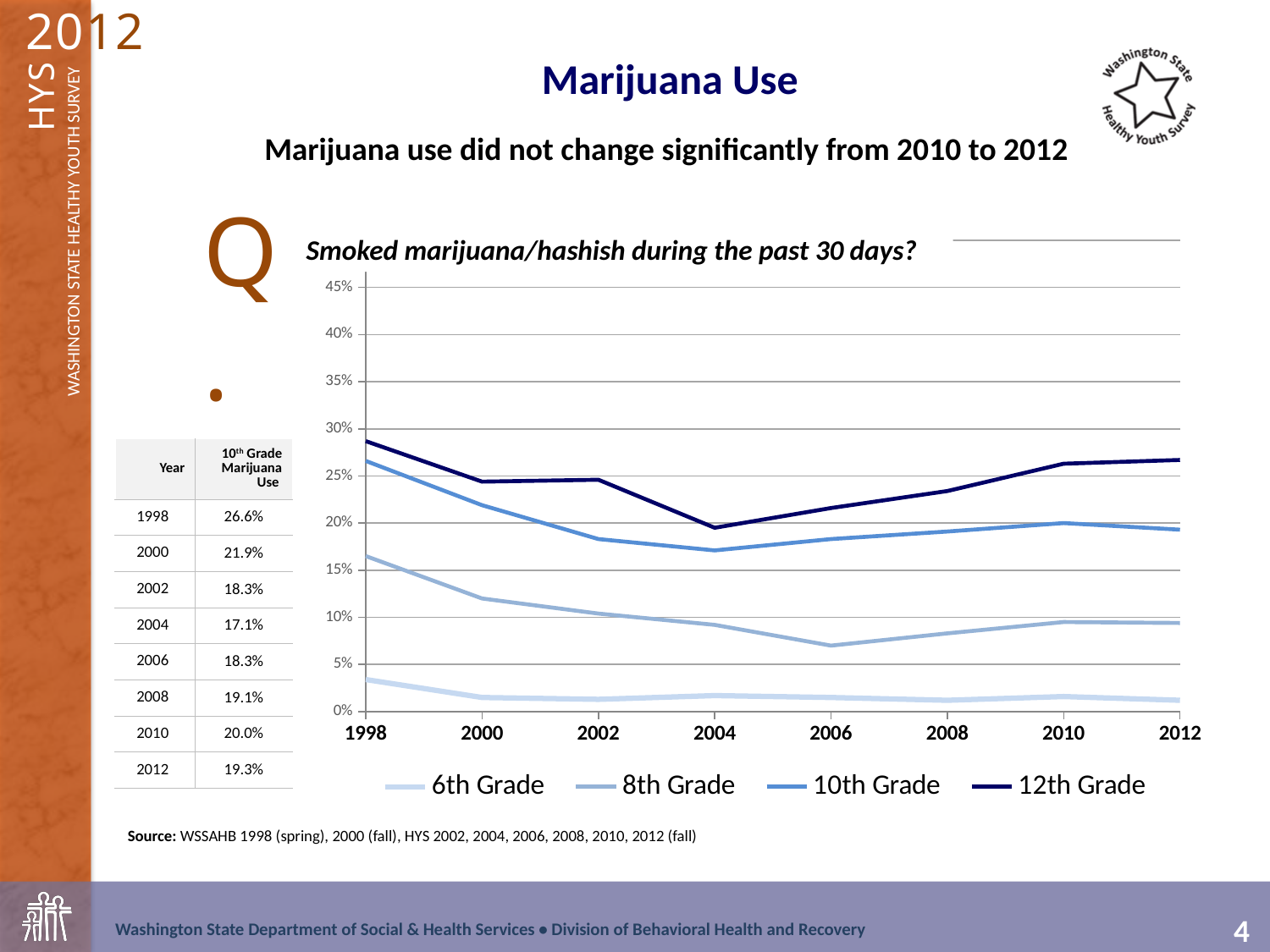
What is the difference between the 10th Grade values for 1998 and 2004? 9.5% How many years are plotted along the x axis of the chart? 8 According to the slide, what was the 10th Grade marijuana use value in 2012? 19.3% How many series does the legend of the chart list? 4 Which grade has the highest value in 2012? 12th Grade What kind of chart is shown on the slide? line chart Is the value for 12th Grade in 1998 greater or less than 25%? greater Does the 8th Grade line rise or fall from 1998 to 2006? fall According to the slide, what was the 10th Grade marijuana use value in 1998? 26.6% Is the value for 8th Grade in 2006 greater or less than 10%? less In which year was 10th Grade marijuana use lowest? 2004 Which grade has the lowest value in 1998? 6th Grade